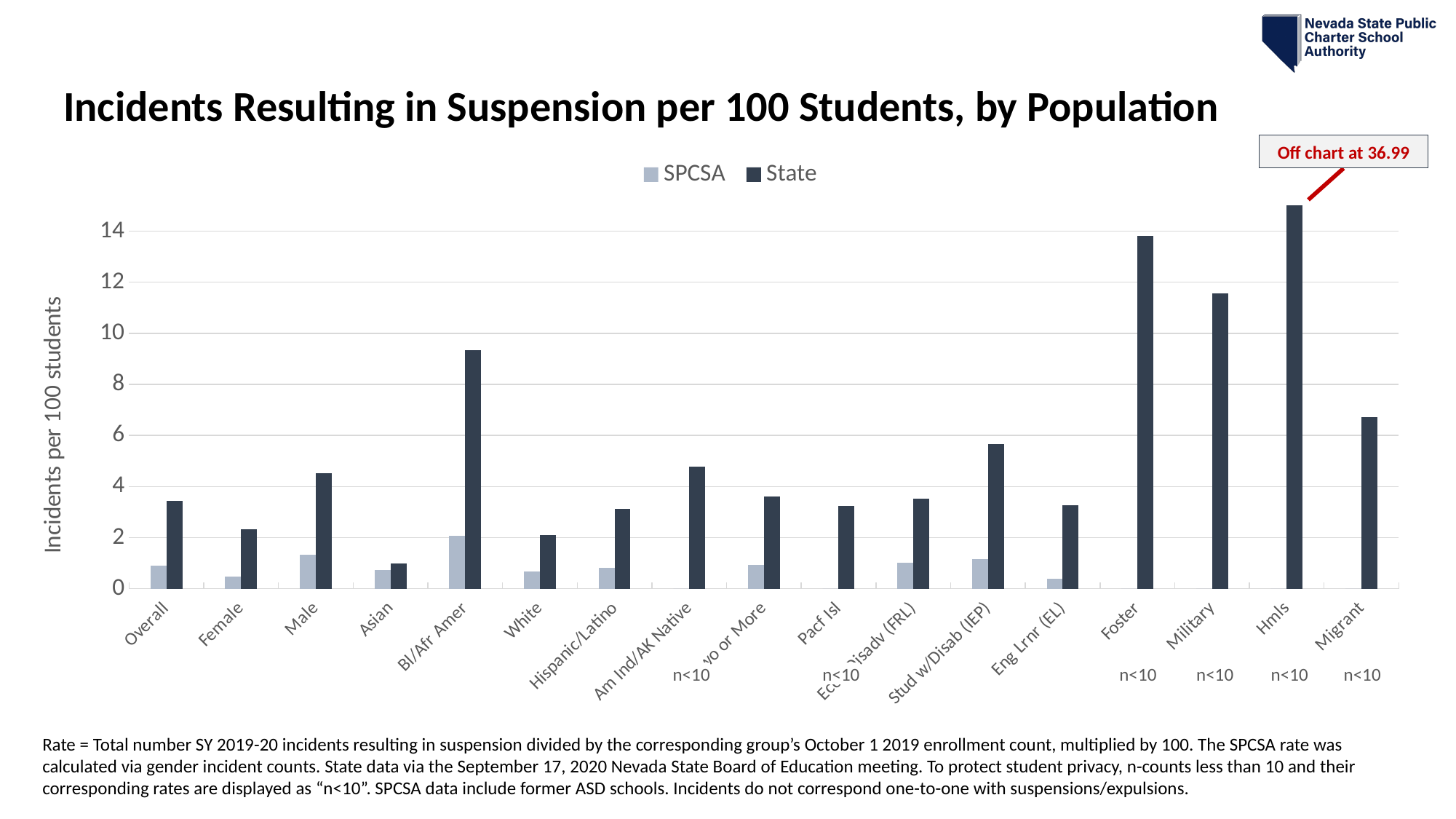
What is the y-axis title of the chart? Incidents per 100 students What are the two series named in the legend? SPCSA and State Which population has the highest State value? Hmls Which is larger, the State value for Male or the State value for Female? Male Is the SPCSA value for Overall greater or less than 2? less How many population categories are shown on the x axis? 17 How many series does the legend list? 2 Is the State value for Bl/Afr Amer greater or less than 8? greater Is the State value for Foster greater or less than 12? greater Which population has the lowest State value? Asian What type of chart is shown on the slide? bar chart According to the annotation, what is the off-chart State value for Hmls? 36.99